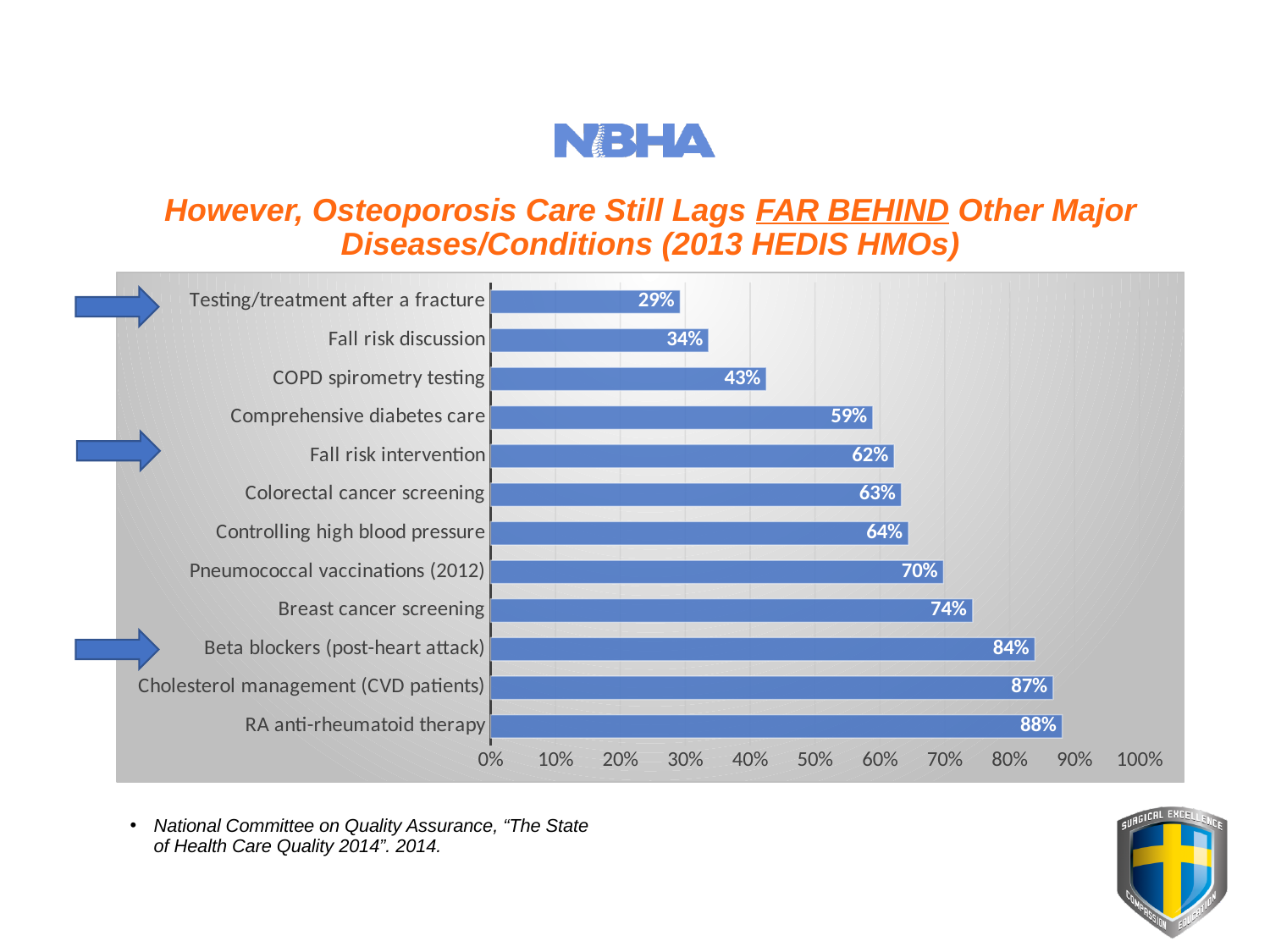
Which is larger, Pneumococcal vaccinations (2012) or COPD spirometry testing? Pneumococcal vaccinations (2012) How many categories are shown in the chart? 12 What is the difference between Beta blockers (post-heart attack) and Fall risk intervention? 22% Which category has the highest value? RA anti-rheumatoid therapy What is the value for Breast cancer screening? 74% What is the value for Comprehensive diabetes care? 59% Is the value for Colorectal cancer screening greater or less than 50%? greater What kind of chart is shown on the slide? Bar chart What is the value for Testing/treatment after a fracture? 29% Which category has the lowest value? Testing/treatment after a fracture What is the value for Controlling high blood pressure? 64% What is the difference between Cholesterol management (CVD patients) and Fall risk discussion? 53%